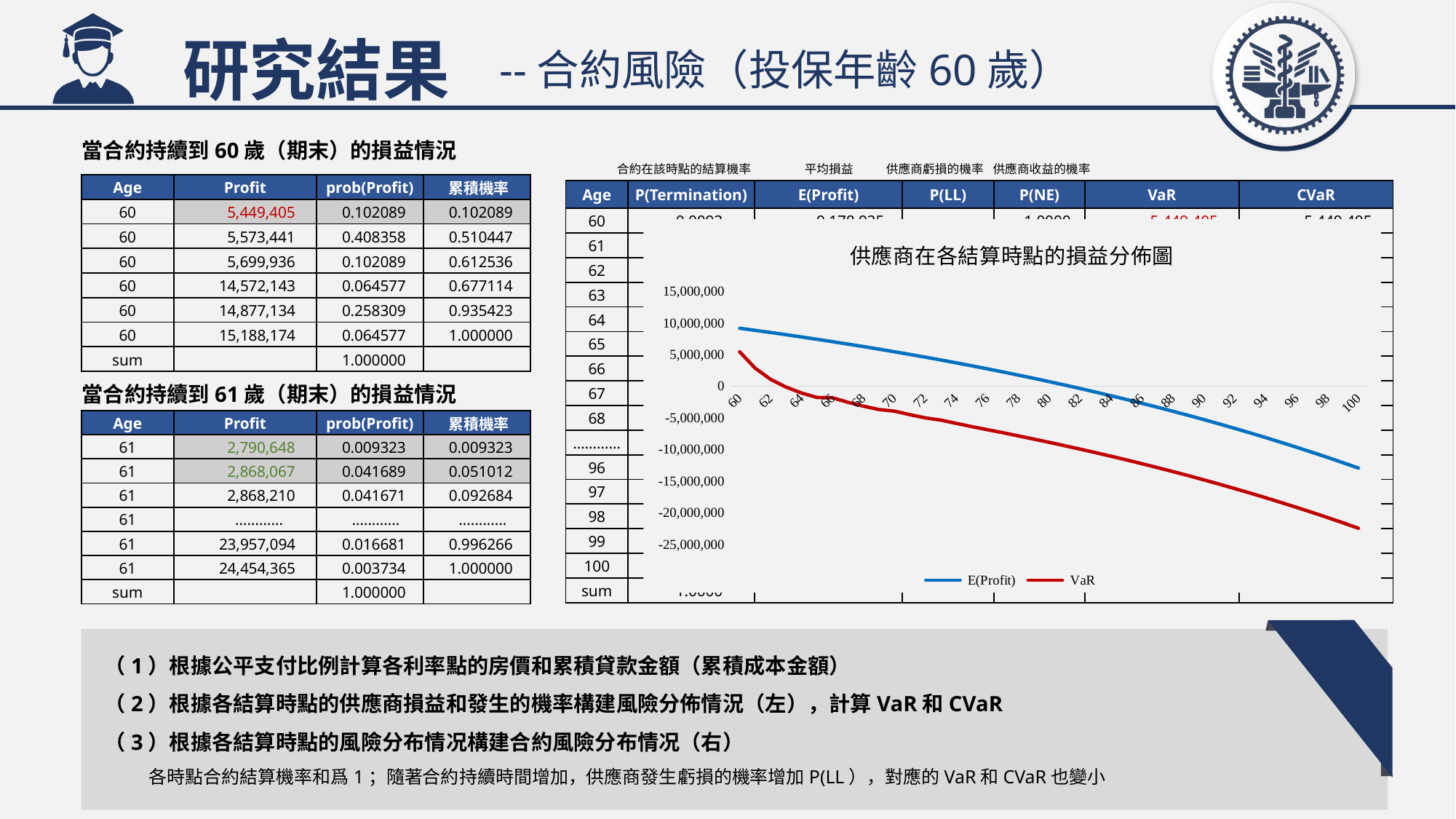
Which series in the line chart is drawn in red? VaR In the line chart, which series has the larger value at age 60, E(Profit) or VaR? E(Profit) In the line chart, does the VaR series rise or fall as age increases from 60 to 100? fall What is the title of the line chart on the right of the slide? 供應商在各結算時點的損益分佈圖 In the line chart, is the E(Profit) value at age 100 greater or less than -10,000,000? less How many series does the legend of the line chart list? 2 In the line chart, is the VaR value at age 80 greater or less than -5,000,000? less What kind of chart is the chart titled 供應商在各結算時點的損益分佈圖? line chart In the line chart, is the E(Profit) value at age 60 greater or less than 5,000,000? greater In the line chart, which series has the lower value at age 100, E(Profit) or VaR? VaR In the line chart, does the E(Profit) series rise or fall as age increases from 60 to 100? fall